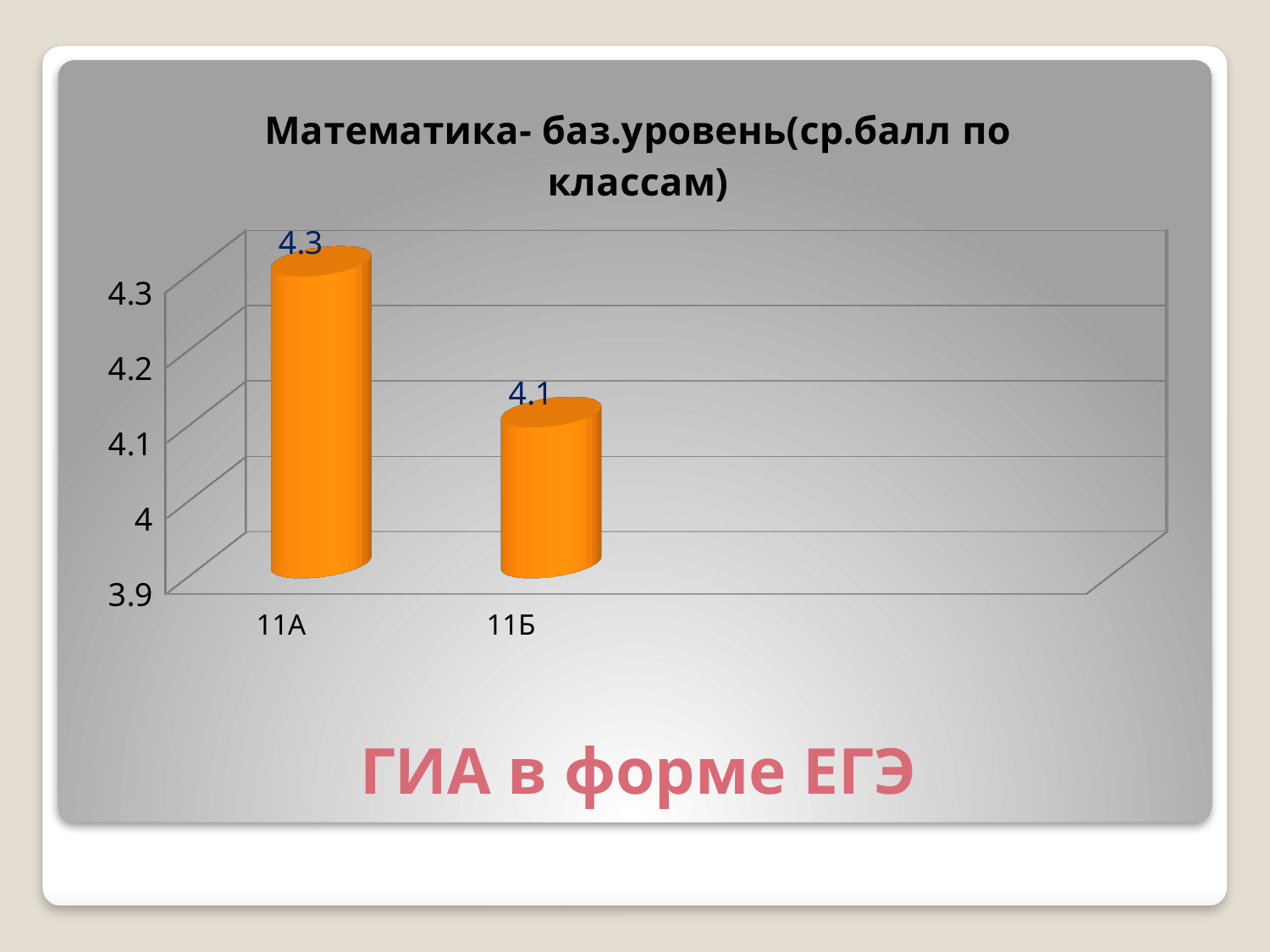
Which class has the lowest average score? 11Б What is the average score for class 11Б? 4.1 What is the difference between the average scores of 11А and 11Б? 0.2 What is the average score for class 11А? 4.3 What is the title of the chart? Математика- баз.уровень(ср.балл по классам) What kind of chart is shown on the slide? bar chart Which class has the highest average score? 11А Do the values rise or fall from 11А to 11Б? fall How many classes are shown in the chart? 2 Which class has a higher average score, 11А or 11Б? 11А Is the value for 11Б greater or less than 4.2? less Is the value for 11А greater or less than 4.2? greater